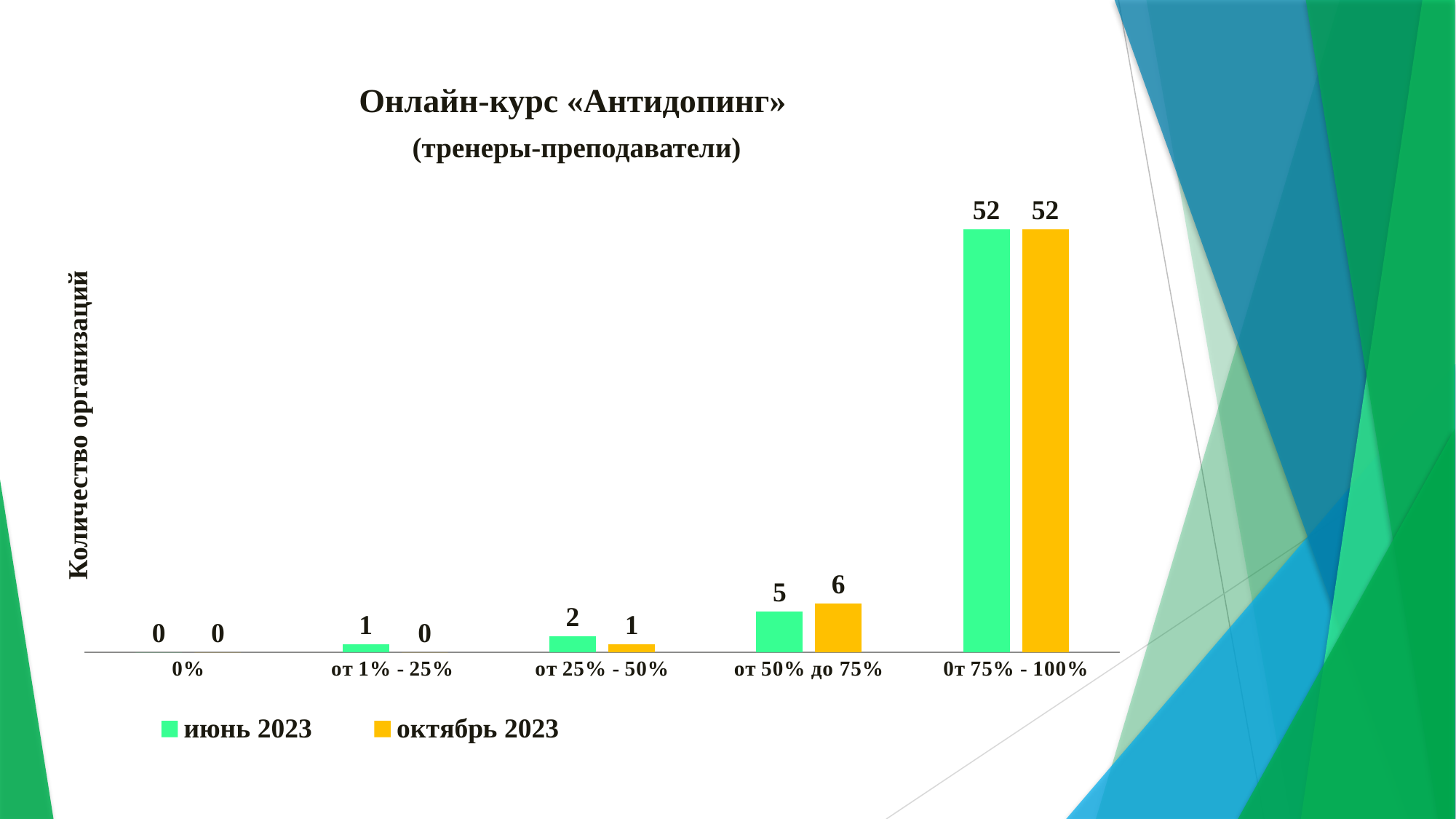
What is the difference between the июнь 2023 and октябрь 2023 values in the category от 50% до 75%? 1 What is the difference between the июнь 2023 values for от 75% - 100% and от 50% до 75%? 47 What kind of chart is shown on the slide? bar chart Which category has the highest value for октябрь 2023? от 75% - 100% How many series does the legend list? 2 What is the value for июнь 2023 in the category от 25% - 50%? 2 What is the value for октябрь 2023 in the category от 1% - 25%? 0 What is the value for октябрь 2023 in the category от 50% до 75%? 6 How many categories are shown on the x axis? 5 In the category от 25% - 50%, which series has the larger value, июнь 2023 or октябрь 2023? июнь 2023 What is the label of the vertical axis? Количество организаций What is the value for июнь 2023 in the category от 75% - 100%? 52